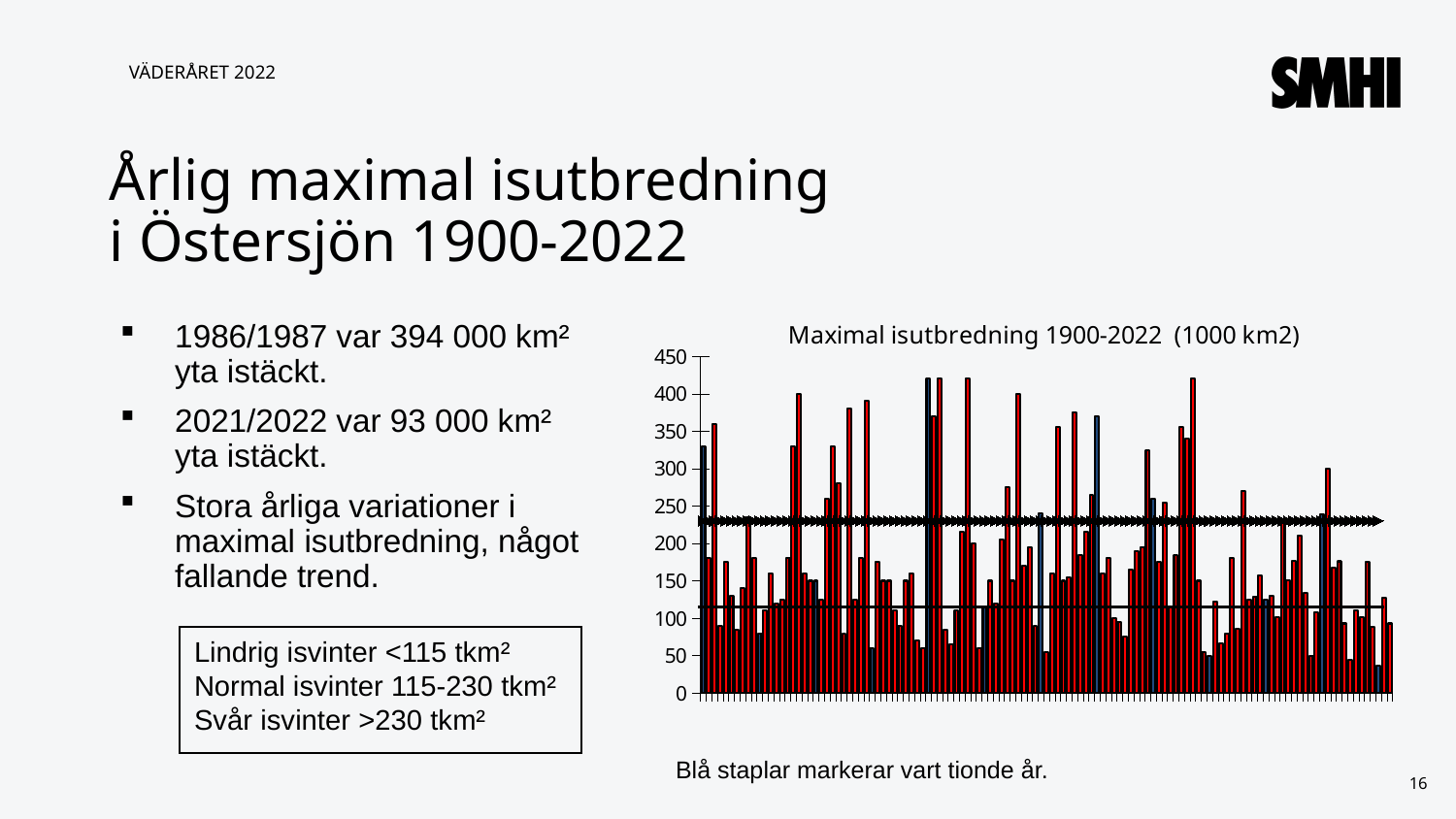
Is the value of the last bar in the chart (2022) greater or less than the value of the first bar (1900)? less Is the value of the last bar in the chart (2022) greater or less than 150? less What is the step between consecutive tick marks on the chart's vertical axis? 50 What kind of chart is shown on the slide? Bar chart What is the title of the chart? Maximal isutbredning 1900-2022 (1000 km2) Does any bar in the chart exceed the 450 tick on the vertical axis? No What do the blue bars in the chart mark, according to the slide? Vart tionde år (every tenth year) Is the value of the first bar in the chart (1900) greater or less than 300? greater